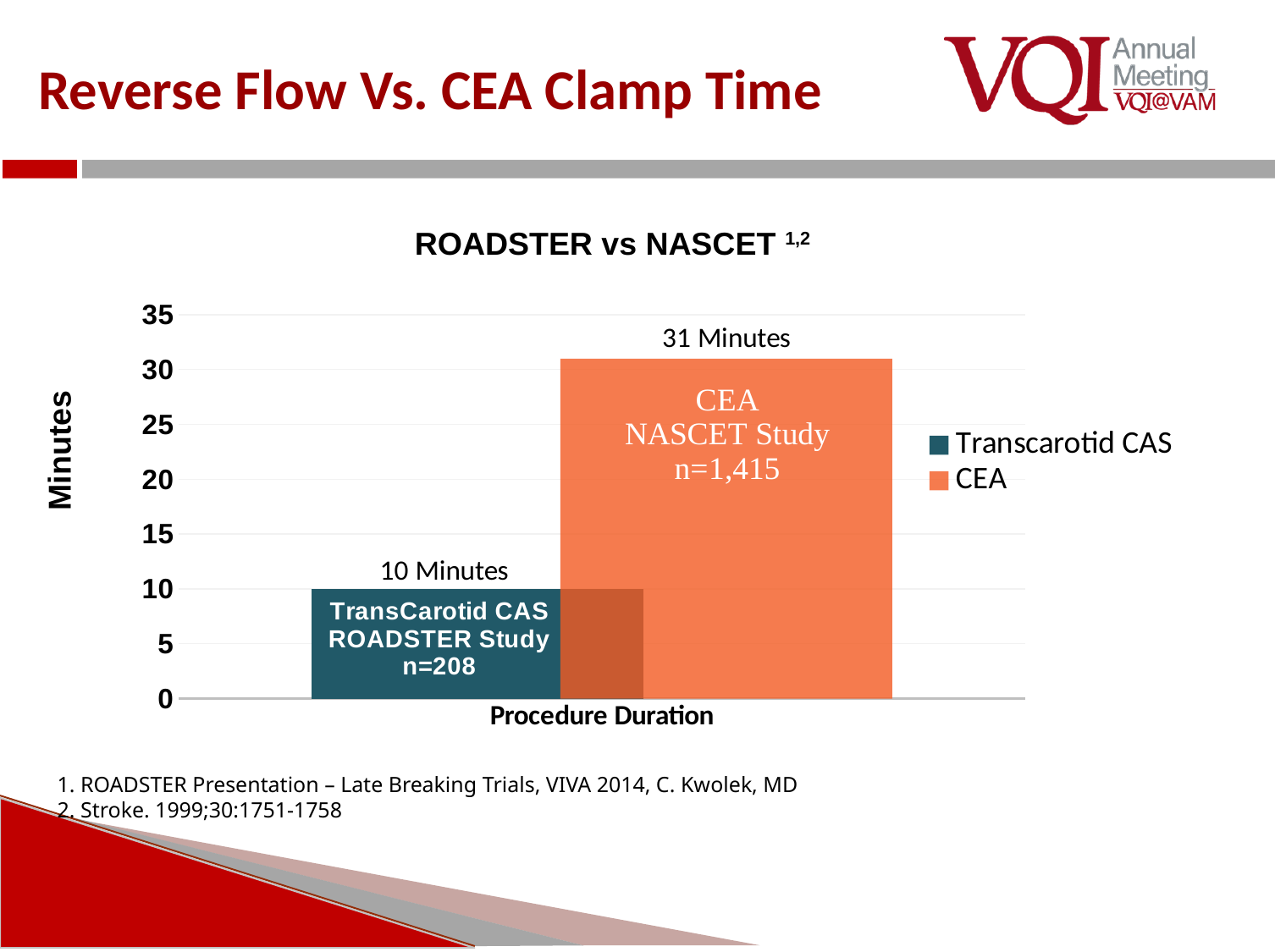
How many series does the legend list? 2 Which series has the shorter procedure duration? Transcarotid CAS Which series has the longer procedure duration? CEA Is the procedure duration for CEA greater or less than 30 minutes? greater Is the procedure duration for Transcarotid CAS greater or less than 15 minutes? less What is the difference in minutes between the CEA and Transcarotid CAS procedure durations? 21 What is the sample size (n) shown for the CEA NASCET Study bar? n=1,415 What is the title of the chart? ROADSTER vs NASCET What is the procedure duration for CEA? 31 Minutes What is the label on the vertical axis of the chart? Minutes What kind of chart is shown on the slide? Bar chart What is the procedure duration for Transcarotid CAS? 10 Minutes